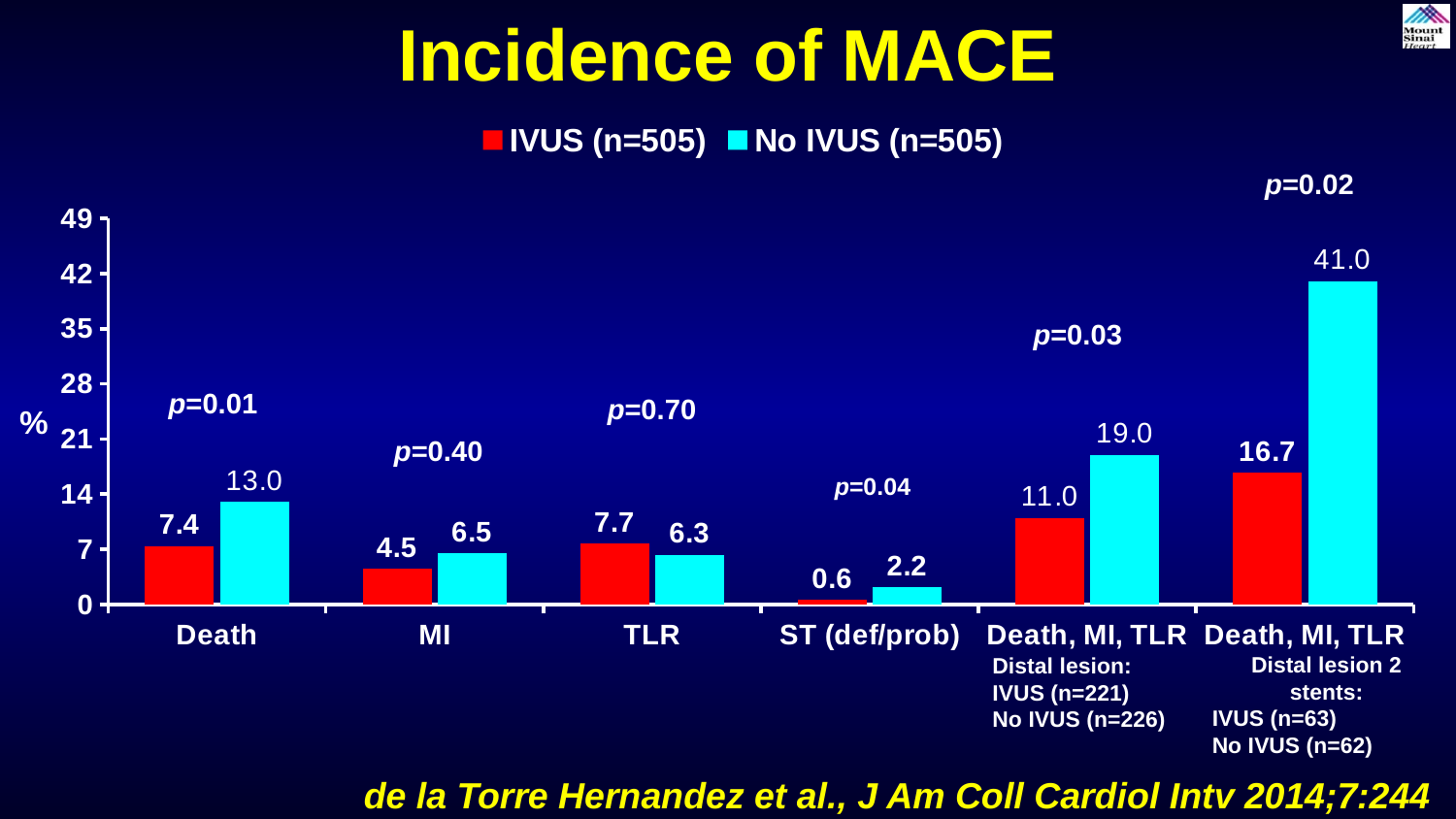
How many categories are shown on the x axis? 6 What is the No IVUS value for MI? 6.5 What is the difference between the No IVUS and IVUS values for Death? 5.6 What kind of chart is shown on the slide? Bar chart What is the No IVUS value for the Death, MI, TLR category with distal lesion 2 stents? 41.0 Which category has the highest No IVUS value? Death, MI, TLR (Distal lesion 2 stents) What is the IVUS value for Death? 7.4 What is the p-value shown above the Death, MI, TLR category with distal lesion 2 stents? p=0.02 For TLR, which is larger: the IVUS value or the No IVUS value? IVUS What is the IVUS value for ST (def/prob)? 0.6 Which category has the lowest IVUS value? ST (def/prob) How many series does the legend list? 2